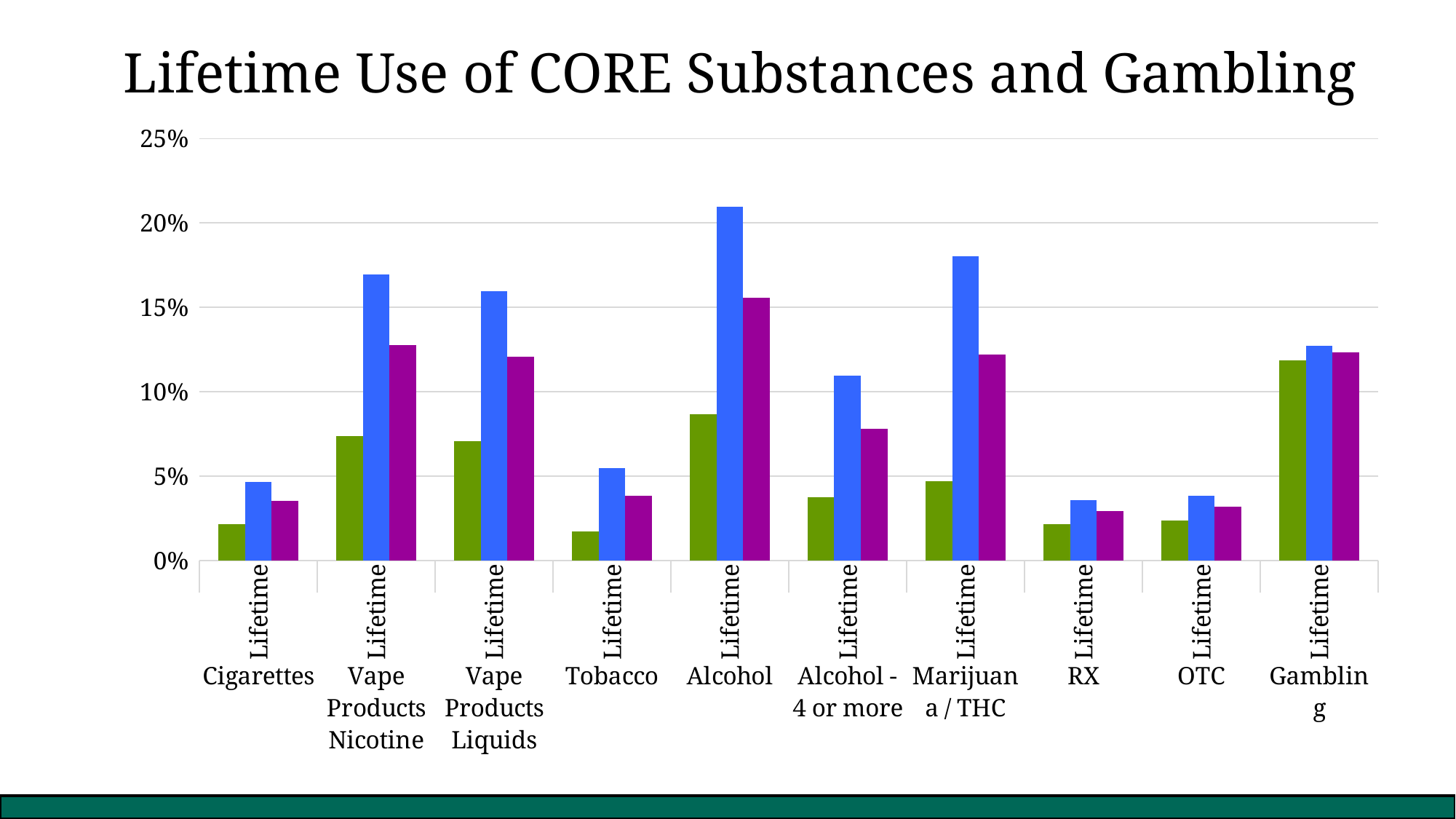
How many categories are shown along the x axis of the chart? 10 Is the blue bar for Marijuana / THC greater or less than 15%? greater Which is larger, the blue bar for Alcohol or the blue bar for Marijuana / THC? Alcohol Which category has the tallest blue bar? Alcohol Is the blue bar for Alcohol greater or less than 20%? greater Which is larger, the green bar for Gambling or the green bar for Alcohol? Gambling Is the purple bar for Vape Products Nicotine greater or less than 10%? greater What is the title of the chart? Lifetime Use of CORE Substances and Gambling Which category has the tallest green bar? Gambling What kind of chart is shown on the slide? bar chart